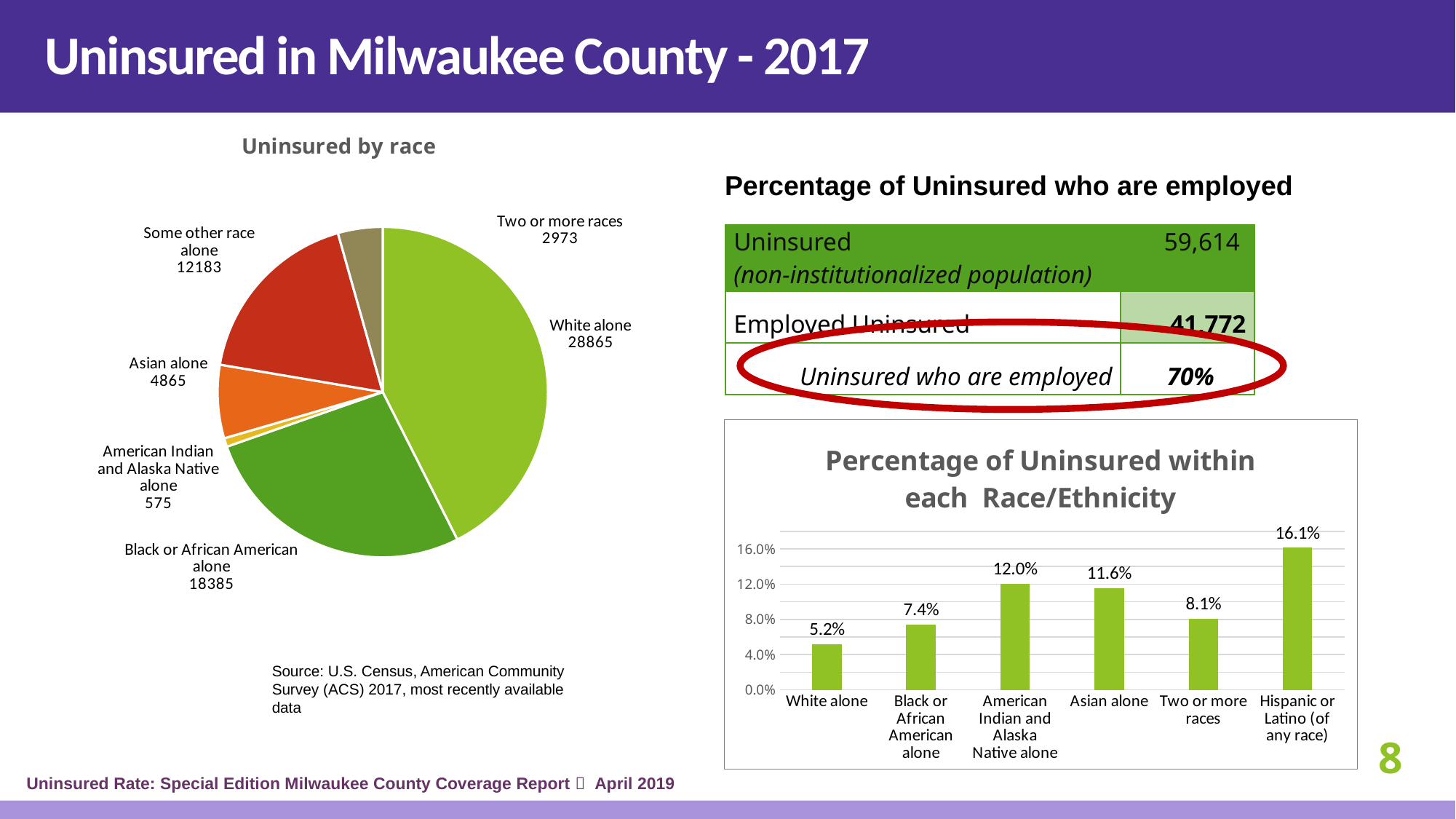
In the 'Uninsured by race' pie chart, which category has the largest slice? White alone In the 'Uninsured by race' pie chart, which category has the smallest slice? American Indian and Alaska Native alone What type of chart is 'Percentage of Uninsured within each Race/Ethnicity'? Bar chart In the 'Percentage of Uninsured within each Race/Ethnicity' chart, what is the difference between 'American Indian and Alaska Native alone' and 'Black or African American alone'? 4.6% In the 'Uninsured by race' pie chart, what is the value for 'Black or African American alone'? 18385 In the 'Uninsured by race' pie chart, how many uninsured people are in the 'White alone' category? 28865 In the 'Percentage of Uninsured within each Race/Ethnicity' chart, which is larger: 'Asian alone' or 'Two or more races'? Asian alone In the 'Uninsured by race' pie chart, how many categories are shown? 6 What type of chart is 'Uninsured by race'? Pie chart In the 'Percentage of Uninsured within each Race/Ethnicity' chart, what is the value for 'Hispanic or Latino (of any race)'? 16.1% In the 'Percentage of Uninsured within each Race/Ethnicity' chart, which category has the lowest percentage? White alone In the 'Uninsured by race' pie chart, what is the difference between the 'Some other race alone' value and the 'Asian alone' value? 7318